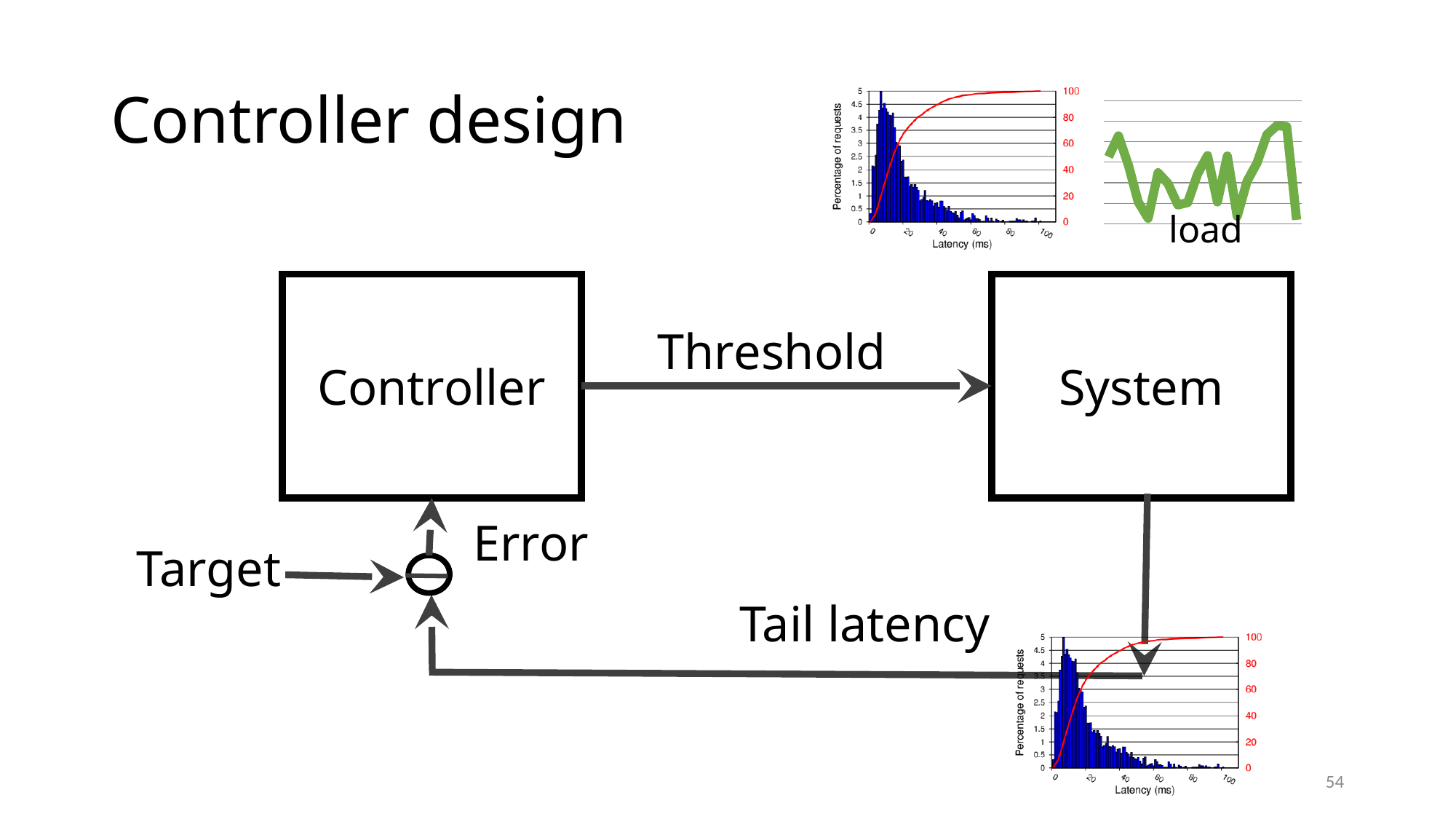
What is the maximum value shown on the left-hand axis of the top-right latency chart? 5 In the top-right latency chart, is the tallest blue bar located at a latency less than or greater than 20 ms? less In the top-right latency chart, do the blue bars rise or fall as latency increases beyond the peak? fall What kind of chart is the top-right chart with the blue bars? bar chart (histogram) with a line overlay What is the left y-axis label of the bottom-right latency chart? Percentage of requests In the bottom-right latency chart, is the red line's value at 60 ms greater or less than 80 on the right axis? greater What kind of chart is the green 'load' chart at the top right? line chart In the top-right latency chart, does the red line rise or fall as latency increases? rise What is the maximum value shown on the right-hand (red) axis of the bottom-right latency chart? 100 In the bottom-right latency chart, is the blue bar at 80 ms greater or less than 1 on the left axis? less In the top-right latency chart, is the red line's value at 40 ms greater or less than 80 on the right axis? greater What is the x-axis label of the top-right latency chart? Latency (ms)